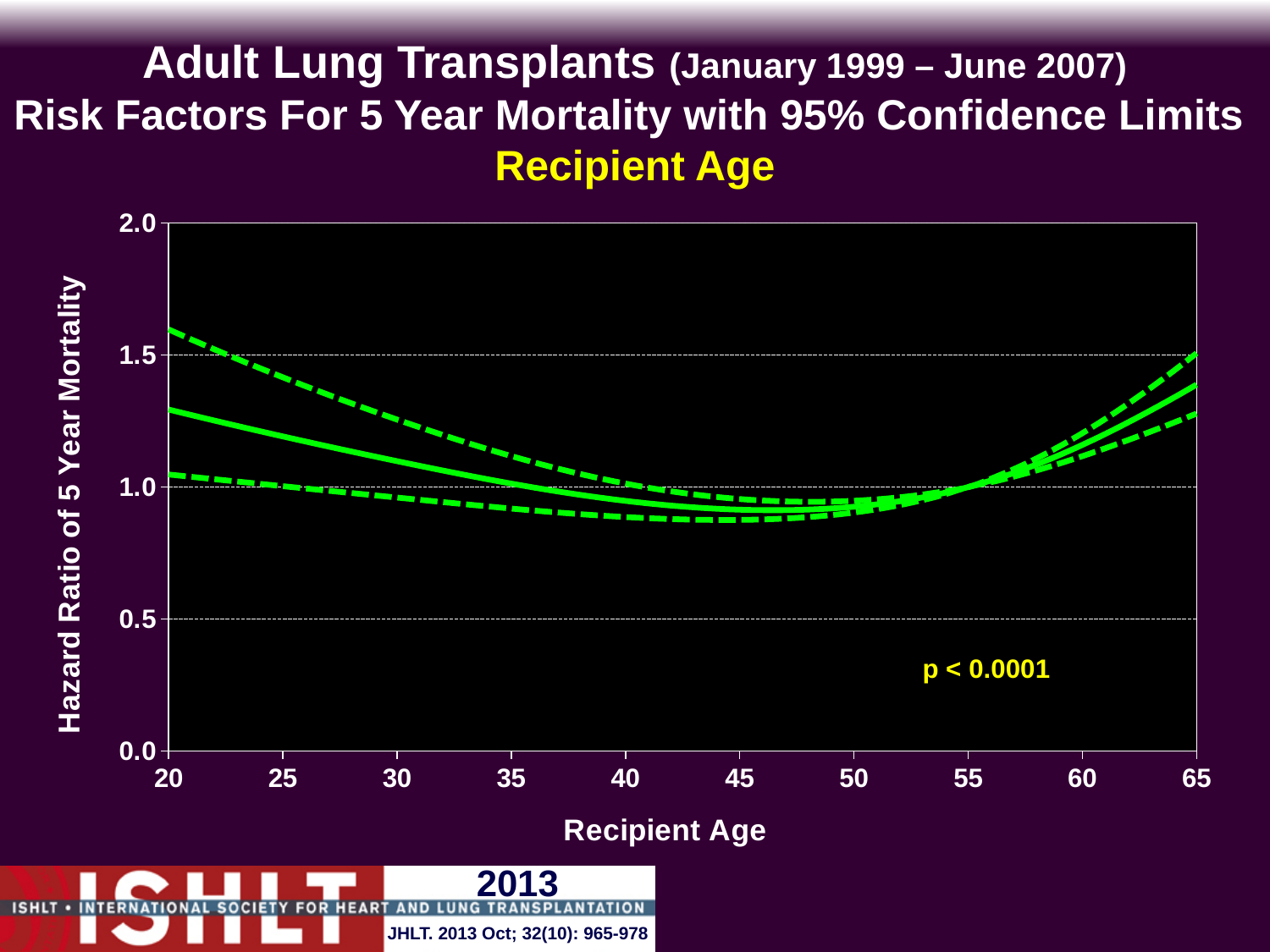
What kind of chart is shown on the slide? Line chart How many lines are plotted on the chart? 3 Is the lower confidence limit (lower dashed line) at recipient age 65 greater or less than 1.5? less Does the hazard ratio (solid line) rise or fall as recipient age increases from 20 to 45? fall Is the hazard ratio (solid line) at recipient age 20 greater or less than 1.0? greater Does the hazard ratio (solid line) rise or fall as recipient age increases from 55 to 65? rise What is the title of the x axis? Recipient Age Is the hazard ratio (solid line) at recipient age 65 greater or less than 1.0? greater Which is larger, the hazard ratio (solid line) at recipient age 20 or at recipient age 45? Age 20 What is the title of the y axis? Hazard Ratio of 5 Year Mortality